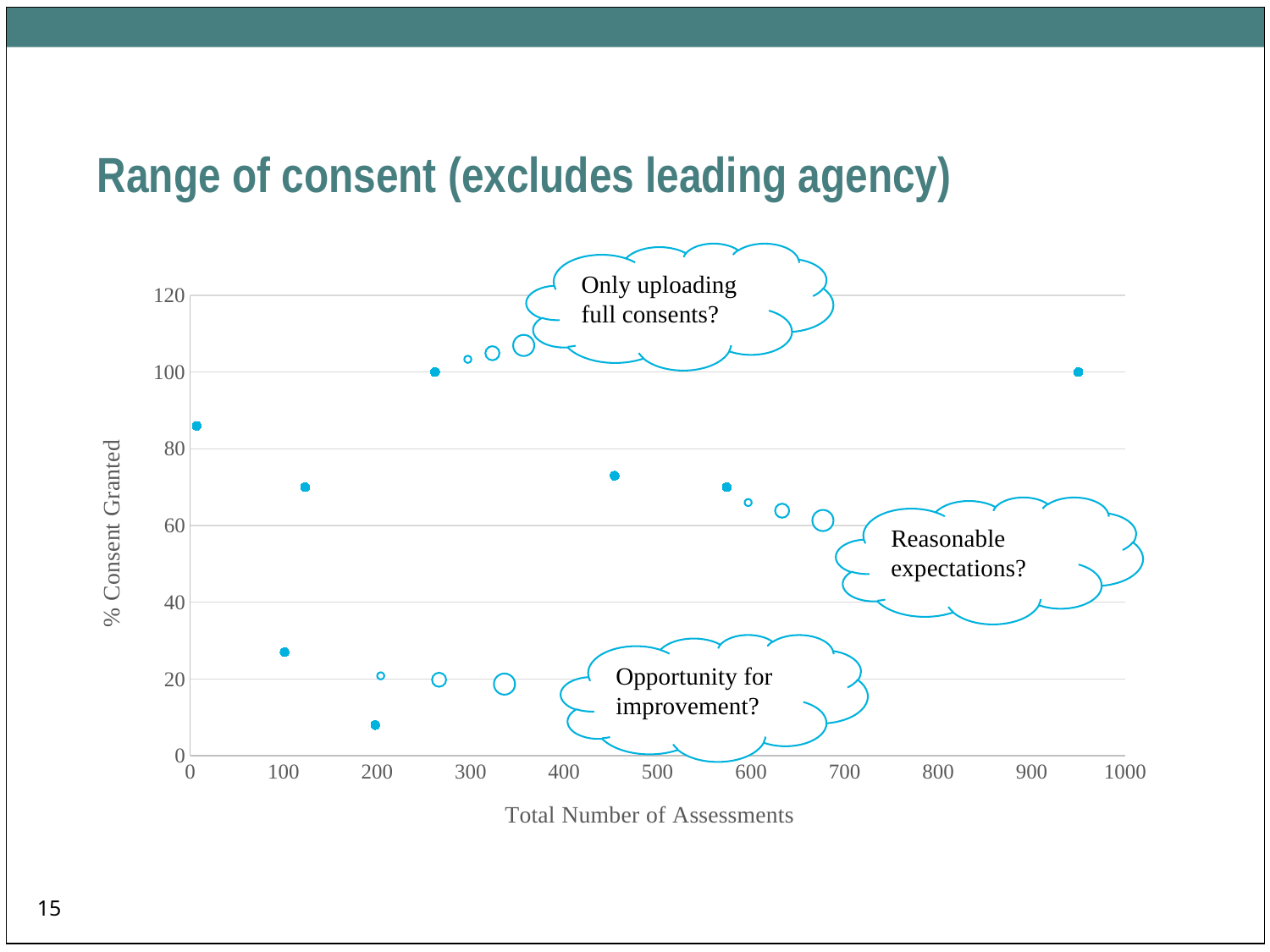
Is the lowest plotted % Consent Granted value greater or less than 20? less What kind of chart is shown on the slide? scatter chart What is the maximum value shown on the Total Number of Assessments axis? 1000 Which has the higher % Consent Granted: the point at about 950 Total Number of Assessments or the point at about 450? the point at about 950 What is the highest % Consent Granted value reached by any plotted point? 100 Is the % Consent Granted for the point at about 450 Total Number of Assessments greater or less than 60? greater Is the % Consent Granted for the point nearest 0 on the Total Number of Assessments axis greater or less than 80? greater What is the label of the vertical axis? % Consent Granted What is the title of the chart on the slide? Range of consent (excludes leading agency)